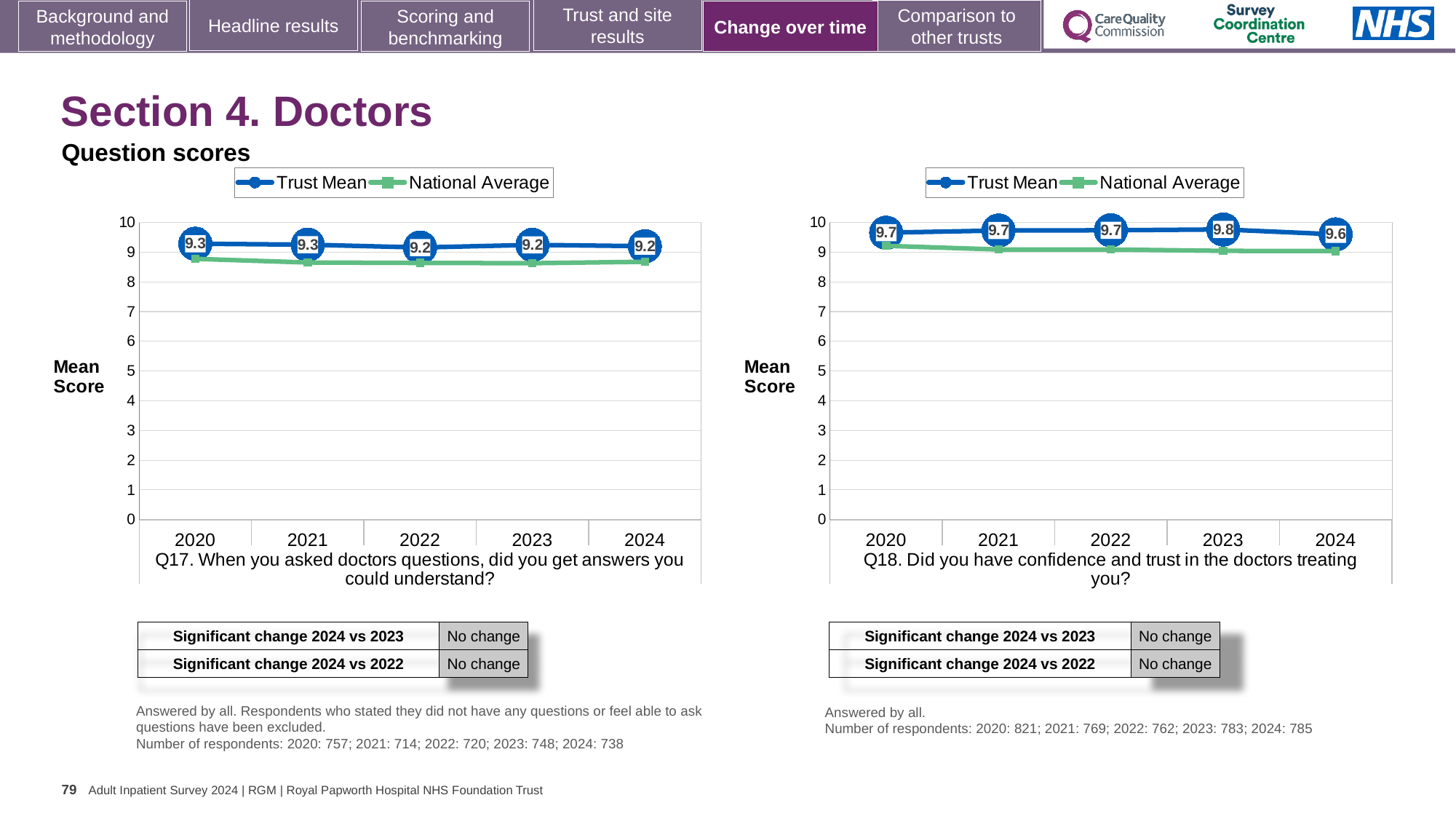
On the Q18 chart (right), is the Trust Mean score higher in 2023 or in 2024? 2023 On the Q17 chart (left), does the Trust Mean score rise or fall from 2020 to 2024? Fall On the Q17 chart (left), what is the Trust Mean score for 2020? 9.3 On the Q18 chart (right), which year has the lowest Trust Mean score? 2024 How many years are shown on the x axis of the Q17 chart (left)? 5 On the Q18 chart (right), is the National Average value for 2024 greater or less than 9.5? less What type of chart is used for Q17 (left)? Line chart How many series does the legend of the Q18 chart (right) list? 2 On the Q18 chart (right), what is the Trust Mean score for 2024? 9.6 On the Q17 chart (left), is the National Average value for 2020 greater or less than 8? greater On the Q18 chart (right), which year has the highest Trust Mean score? 2023 On the Q17 chart (left), what is the difference between the Trust Mean score in 2020 and in 2024? 0.1